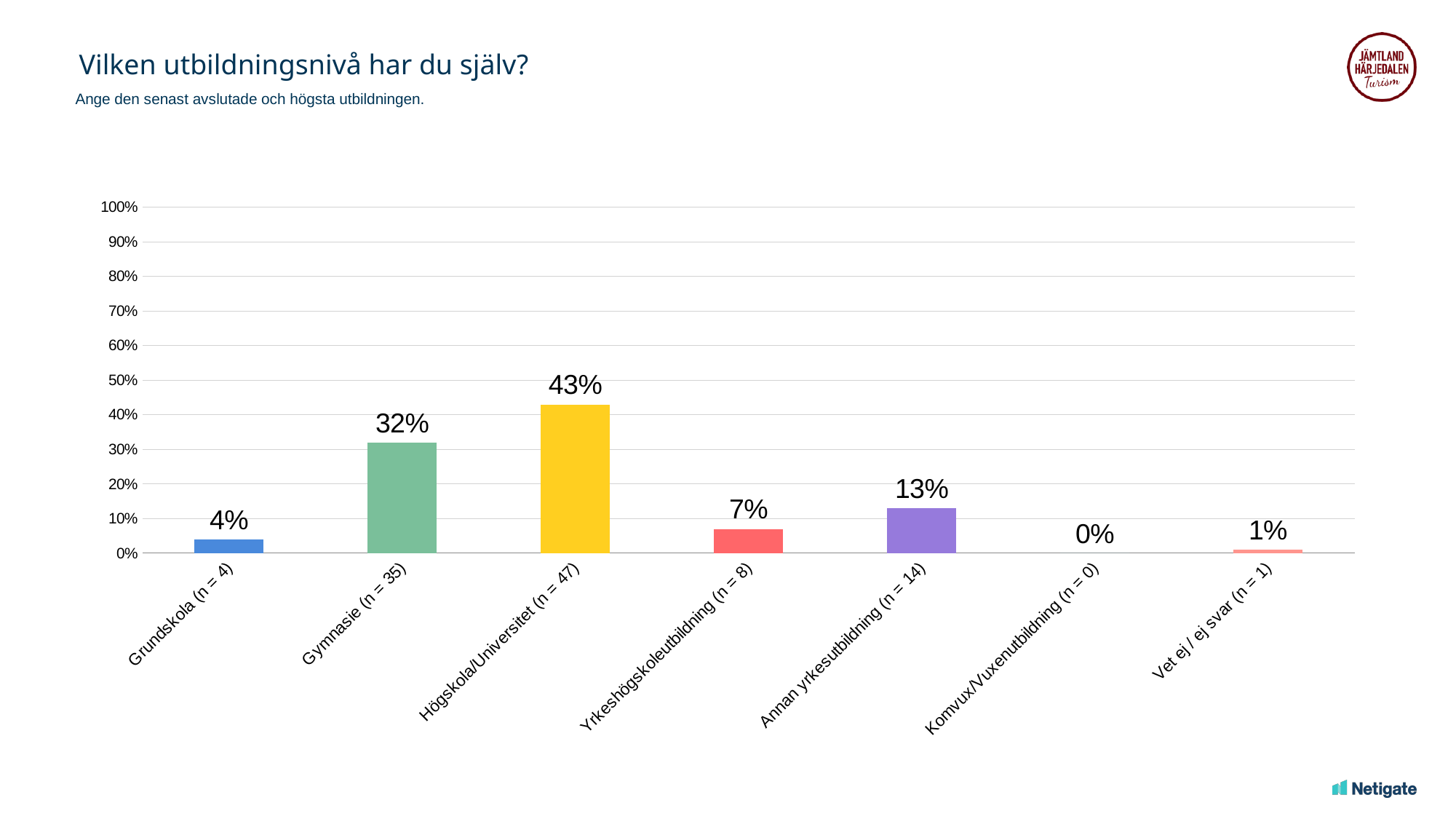
How many categories are shown on the x axis? 7 What is the difference between the values for Högskola/Universitet and Gymnasie? 11% What is the value for Annan yrkesutbildning? 13% What is the title of the chart? Vilken utbildningsnivå har du själv? What is the value for Högskola/Universitet? 43% What is the value for Gymnasie? 32% Which category has the highest value? Högskola/Universitet What is the value for Komvux/Vuxenutbildning? 0% Which category has the lowest value? Komvux/Vuxenutbildning What kind of chart is shown on the slide? bar chart Is the value for Högskola/Universitet greater or less than 50%? less Which is larger, the value for Yrkeshögskoleutbildning or the value for Annan yrkesutbildning? Annan yrkesutbildning